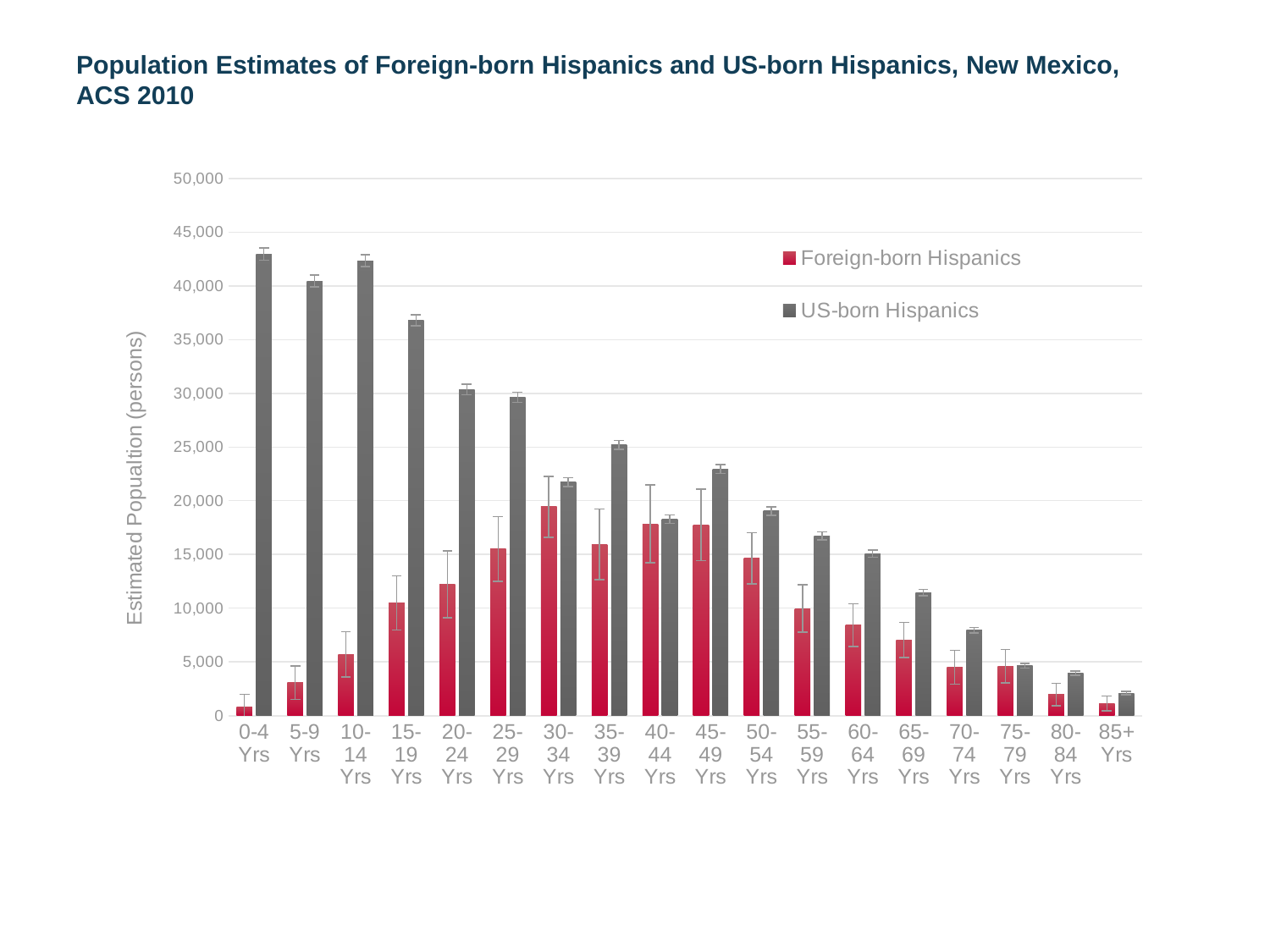
Is the value for Foreign-born Hispanics aged 60-64 Yrs greater or less than 10,000? less What kind of chart is shown on the slide? bar chart For the 30-34 Yrs age group, which series has the larger value, Foreign-born Hispanics or US-born Hispanics? US-born Hispanics Is the value for US-born Hispanics aged 45-49 Yrs greater or less than 20,000? greater Do the values for US-born Hispanics generally rise or fall as age increases along the x axis? fall Which age group has the highest value for Foreign-born Hispanics? 30-34 Yrs Is the value for US-born Hispanics aged 0-4 Yrs greater or less than 40,000? greater How many series does the legend list? 2 How many age-group categories are shown on the x axis? 18 What is the label of the y axis? Estimated Population (persons) Which age group has the lowest value for US-born Hispanics? 85+ Yrs